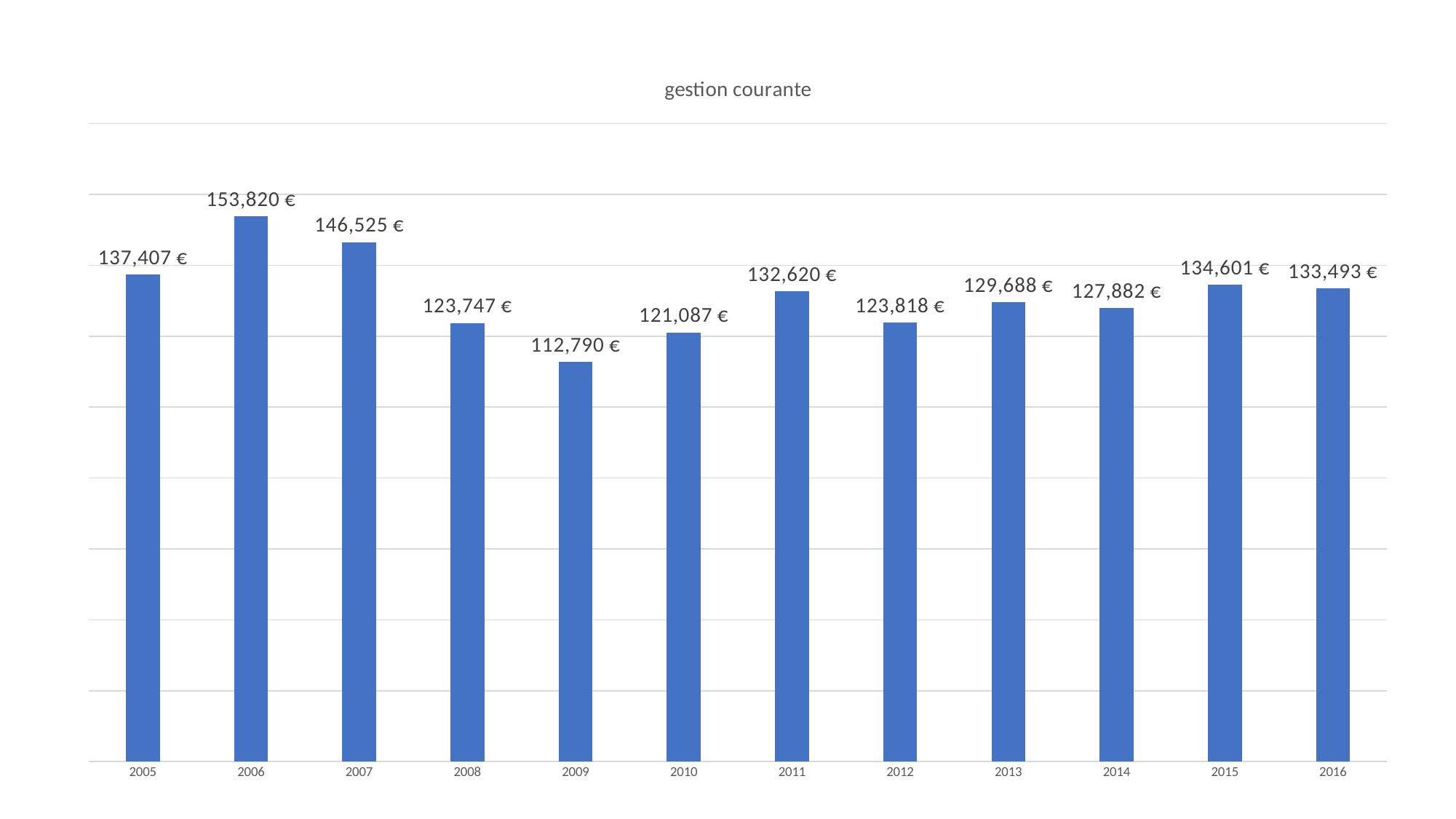
Which is larger, the value for 2005 or the value for 2011? 2005 What is the difference between the values for 2006 and 2007? 7,295 € Which year has the highest value? 2006 What is the value for 2016? 133,493 € What is the value for 2009? 112,790 € How many years are shown on the x axis? 12 What is the difference between the values for 2015 and 2016? 1,108 € Which year has the lowest value? 2009 What is the value for 2006? 153,820 € What is the title of the chart? gestion courante What is the value for 2013? 129,688 € What kind of chart is this? Bar chart